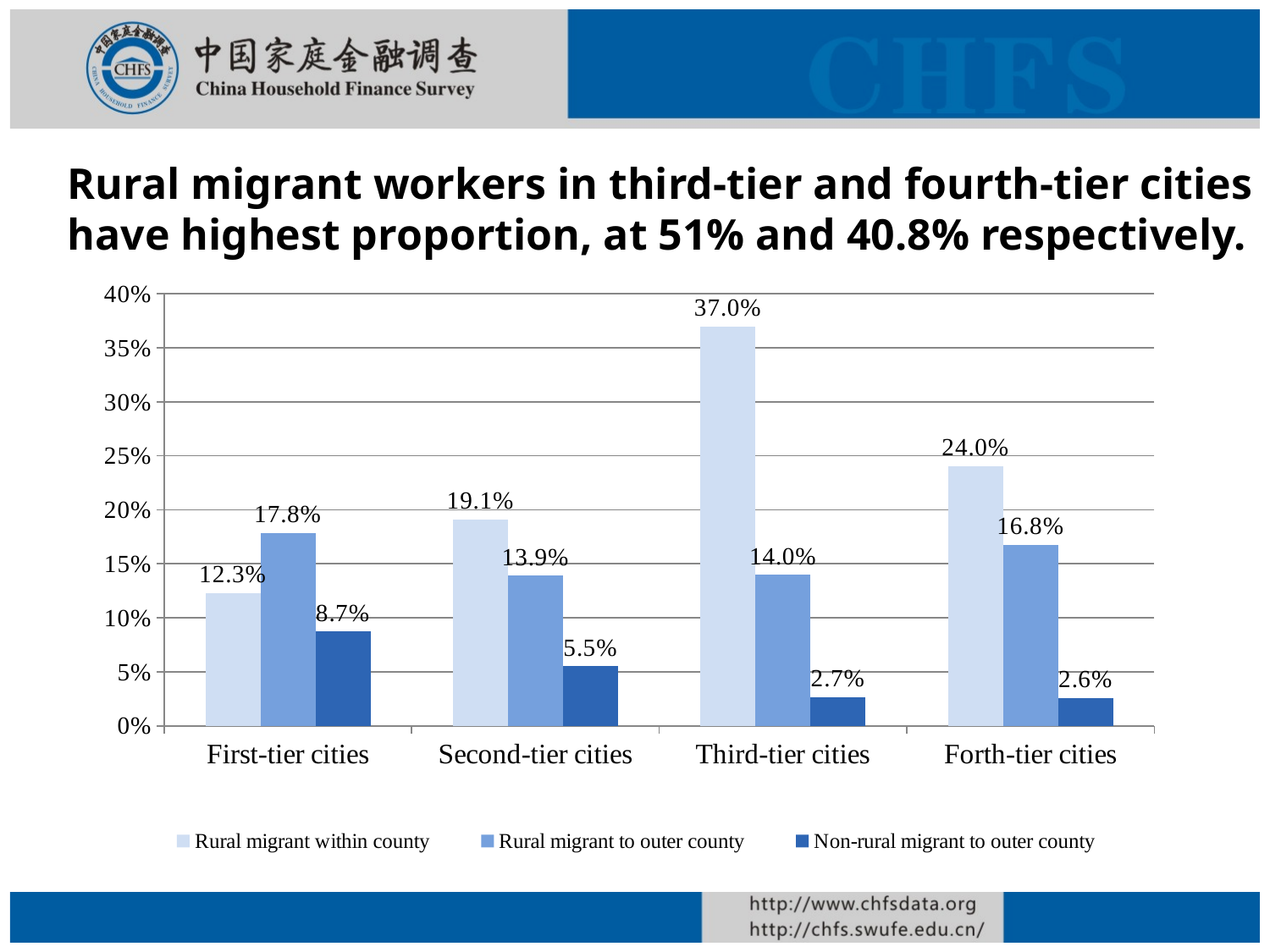
How many city tier categories are shown on the x axis? 4 Does the value for Non-rural migrant to outer county rise or fall from First-tier cities to Forth-tier cities? Fall What is the value for Rural migrant to outer county in Forth-tier cities? 16.8% Which city tier has the lowest value for Non-rural migrant to outer county? Forth-tier cities Is the value for Rural migrant within county in Forth-tier cities greater or less than 20%? greater How many series does the legend list? 3 What kind of chart is shown on the slide? Bar chart Which is larger in First-tier cities: Rural migrant within county or Rural migrant to outer county? Rural migrant to outer county What is the value for Non-rural migrant to outer county in First-tier cities? 8.7% Which city tier has the highest value for Rural migrant within county? Third-tier cities What is the difference between Rural migrant within county and Rural migrant to outer county in Third-tier cities? 23.0% What is the value for Rural migrant within county in Third-tier cities? 37.0%